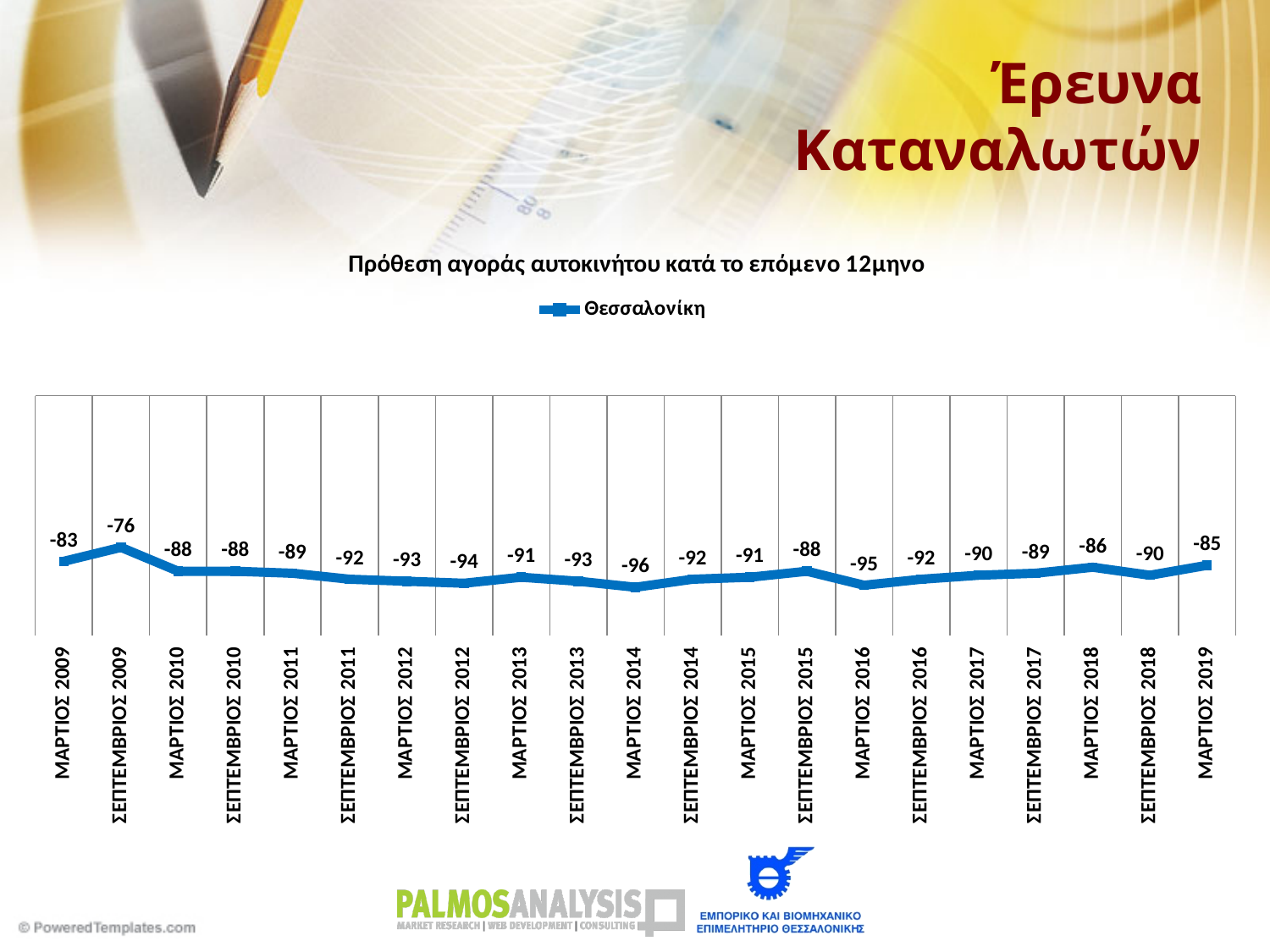
What type of chart is shown on the slide? Line chart What is the value for ΜΑΡΤΙΟΣ 2019? -85 Which period has the highest value? ΣΕΠΤΕΜΒΡΙΟΣ 2009 What is the title of the chart? Πρόθεση αγοράς αυτοκινήτου κατά το επόμενο 12μηνο What is the value for ΣΕΠΤΕΜΒΡΙΟΣ 2015? -88 How many data points are plotted on the chart? 21 What is the difference between the values for ΣΕΠΤΕΜΒΡΙΟΣ 2009 and ΜΑΡΤΙΟΣ 2014? 20 Which is larger, the value for ΜΑΡΤΙΟΣ 2018 or the value for ΣΕΠΤΕΜΒΡΙΟΣ 2018? ΜΑΡΤΙΟΣ 2018 How many series does the legend list? 1 Which period has the lowest value? ΜΑΡΤΙΟΣ 2014 What is the value for ΜΑΡΤΙΟΣ 2009? -83 What is the difference between the values for ΜΑΡΤΙΟΣ 2019 and ΜΑΡΤΙΟΣ 2009? 2